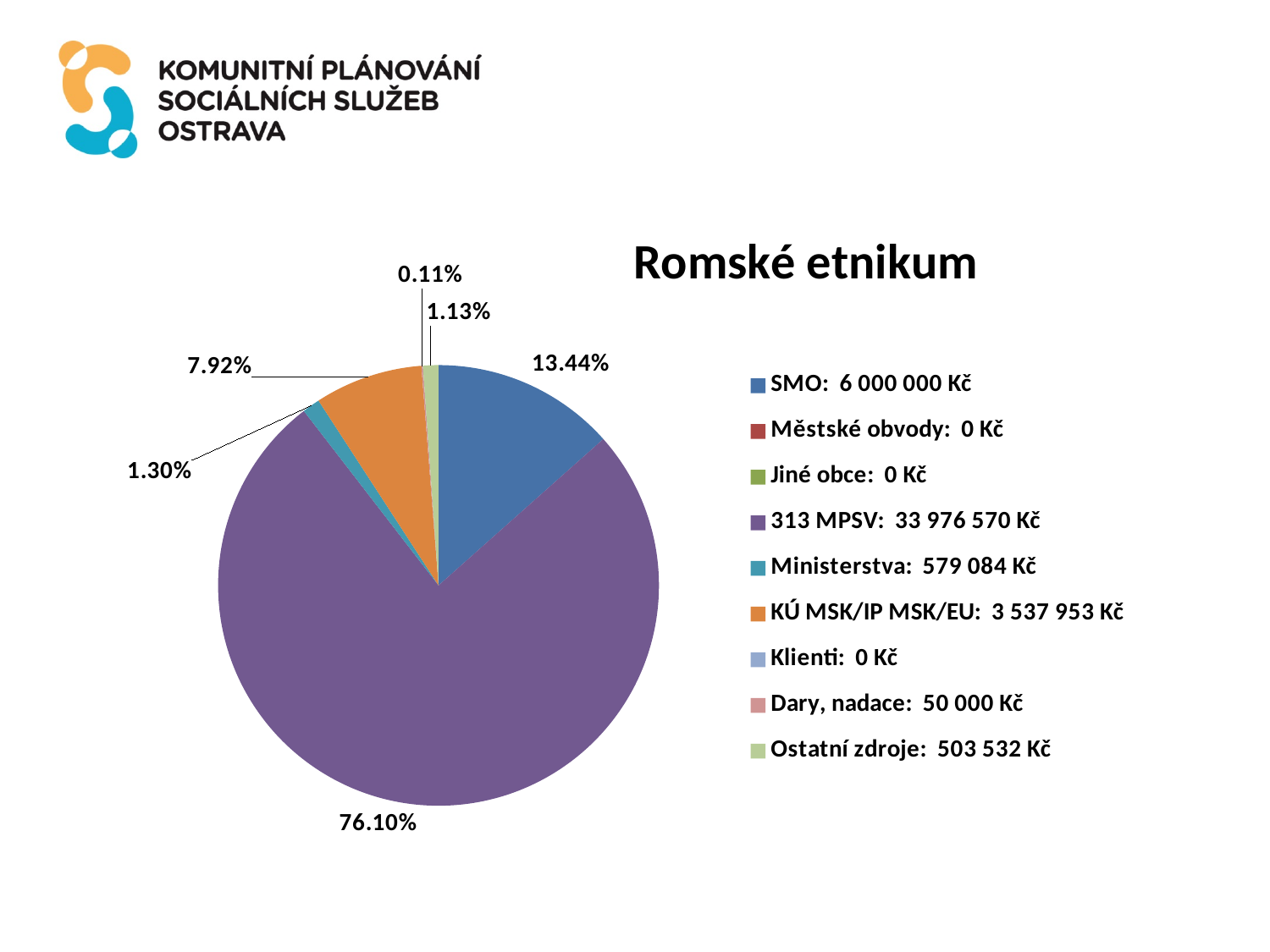
What share of the pie does 313 MPSV represent? 76.10% What share of the pie does SMO represent? 13.44% What is the title of the chart? Romské etnikum How many categories does the legend list? 9 Which category has the largest slice of the pie? 313 MPSV What amount is shown for KÚ MSK/IP MSK/EU in the legend? 3 537 953 Kč What amount is shown for 313 MPSV in the legend? 33 976 570 Kč What amount is shown for Ostatní zdroje in the legend? 503 532 Kč What amount is shown for SMO in the legend? 6 000 000 Kč Which is larger, the amount for SMO or the amount for KÚ MSK/IP MSK/EU? SMO Which category has the smallest labelled percentage on the pie? Dary, nadace What kind of chart is shown on the slide? pie chart